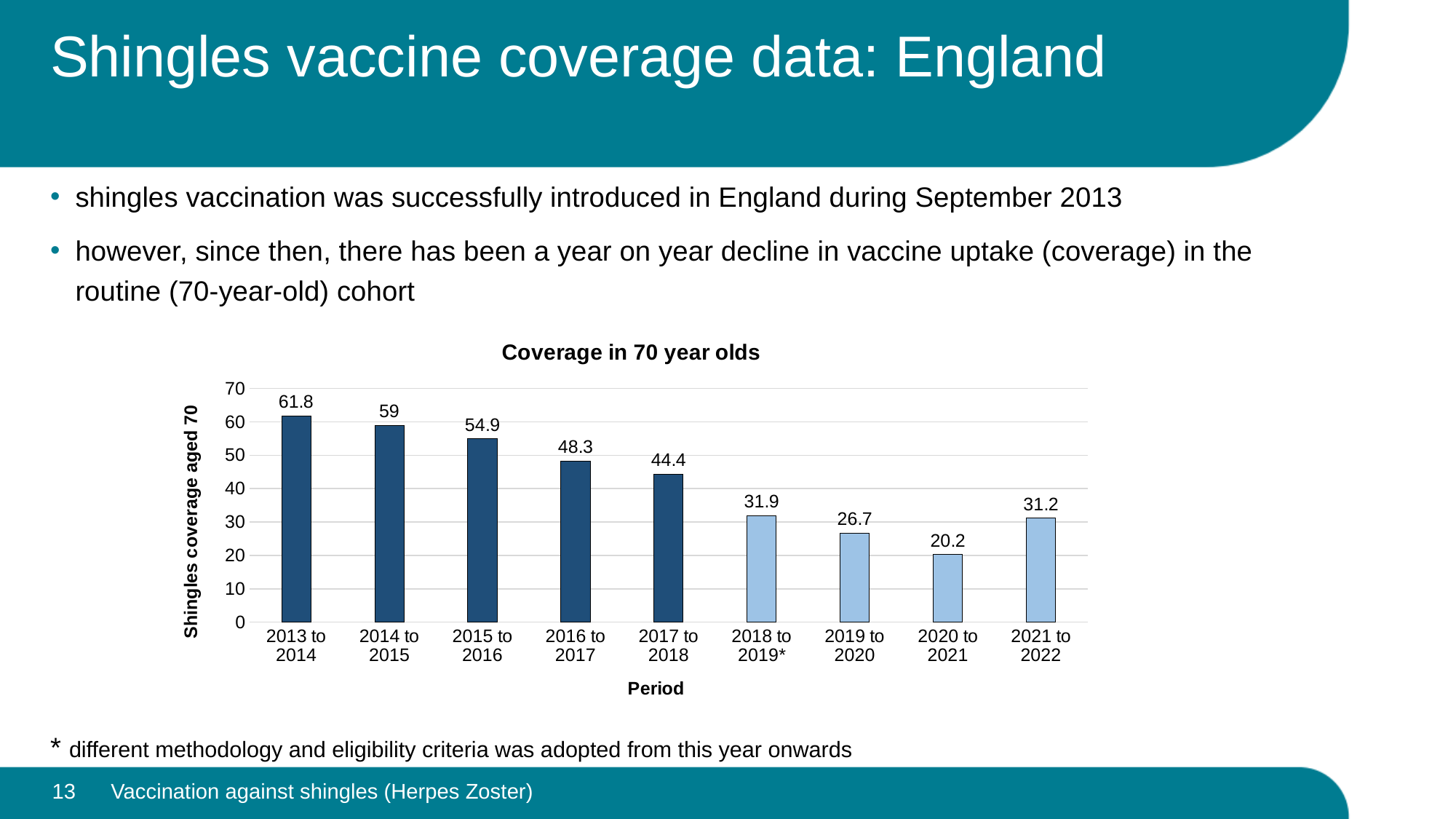
Which is larger, the coverage for 2015 to 2016 or for 2016 to 2017? 2015 to 2016 Is the coverage for 2014 to 2015 greater or less than 50? greater What is the difference in coverage between 2013 to 2014 and 2017 to 2018? 17.4 What is the difference in coverage between 2019 to 2020 and 2020 to 2021? 6.5 What is the coverage value for 2021 to 2022? 31.2 What is the title of the chart? Coverage in 70 year olds Which period has the lowest coverage? 2020 to 2021 How many periods are shown on the x axis? 9 What is the coverage value for 2018 to 2019*? 31.9 Which period has the highest coverage? 2013 to 2014 What kind of chart is shown on the slide? bar chart What is the coverage value for 2013 to 2014? 61.8